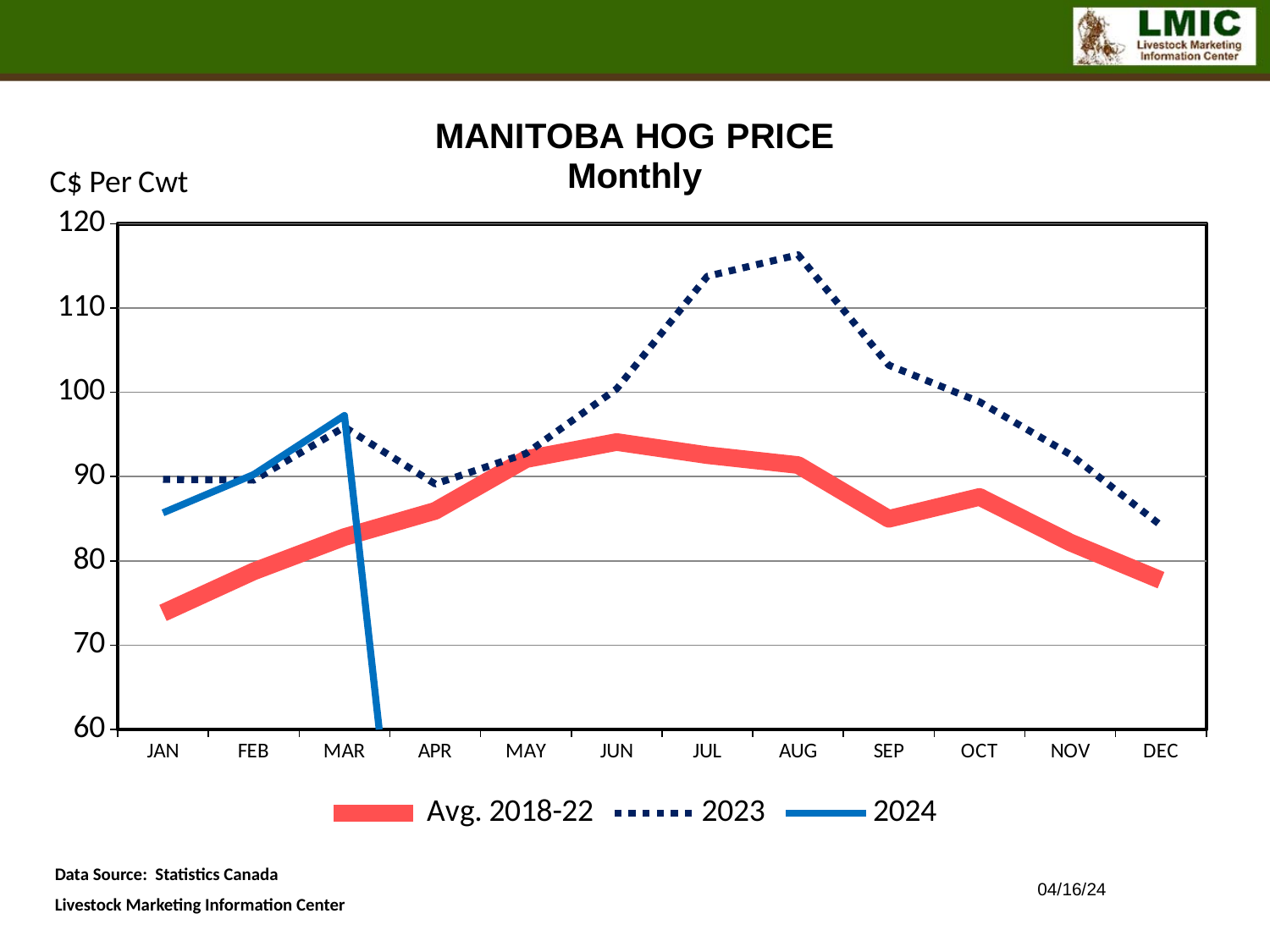
Is the 2023 value for AUG greater or less than 110? greater In AUG, which series has the larger value, 2023 or Avg. 2018-22? 2023 In which month is the Avg. 2018-22 series at its highest? JUN What kind of chart is shown on the slide? line chart Is the Avg. 2018-22 value for JAN greater or less than 80? less How many series does the legend list? 3 In which month is the Avg. 2018-22 series at its lowest? JAN Is the 2024 value for MAR greater or less than 90? greater Does the Avg. 2018-22 series rise or fall from JAN to JUN? rise What unit is shown on the y axis label? C$ Per Cwt How many months are shown along the x axis? 12 In which month does the 2023 series reach its highest value? AUG